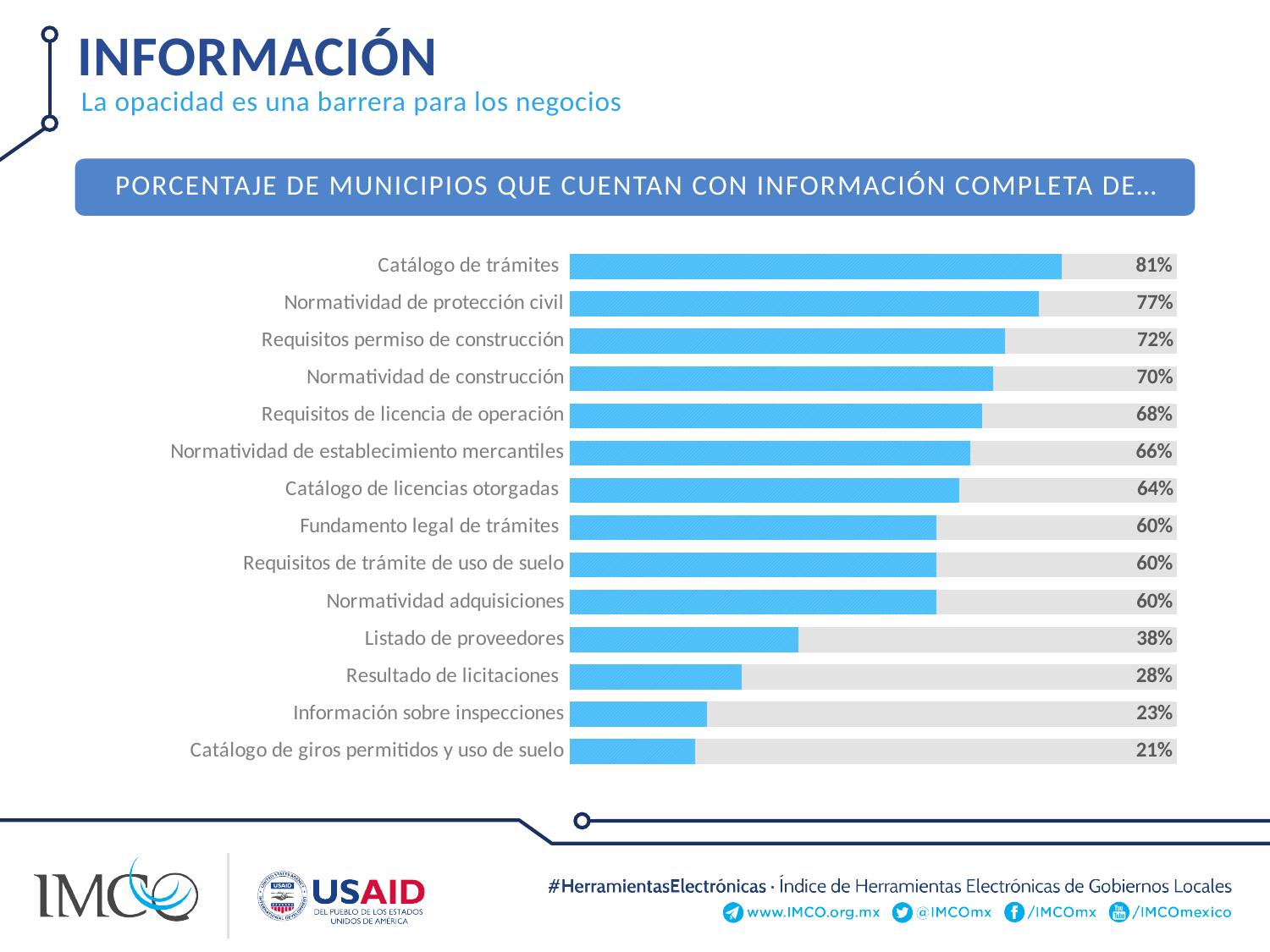
What kind of chart is shown on the slide? Bar chart What is the difference between 'Resultado de licitaciones' and 'Información sobre inspecciones'? 5% Which is larger: the value for 'Requisitos permiso de construcción' or 'Catálogo de licencias otorgadas'? Requisitos permiso de construcción What is the difference between the values for 'Catálogo de trámites' and 'Catálogo de giros permitidos y uso de suelo'? 60% Which category has the lowest percentage? Catálogo de giros permitidos y uso de suelo What is the value shown for 'Listado de proveedores'? 38% What is the value shown for 'Normatividad de construcción'? 70% What is the title of the chart? Porcentaje de municipios que cuentan con información completa de... How many categories share the value 60%? 3 Which category has the highest percentage? Catálogo de trámites What percentage of municipalities have complete information for 'Catálogo de trámites'? 81% How many categories are shown in the chart? 14